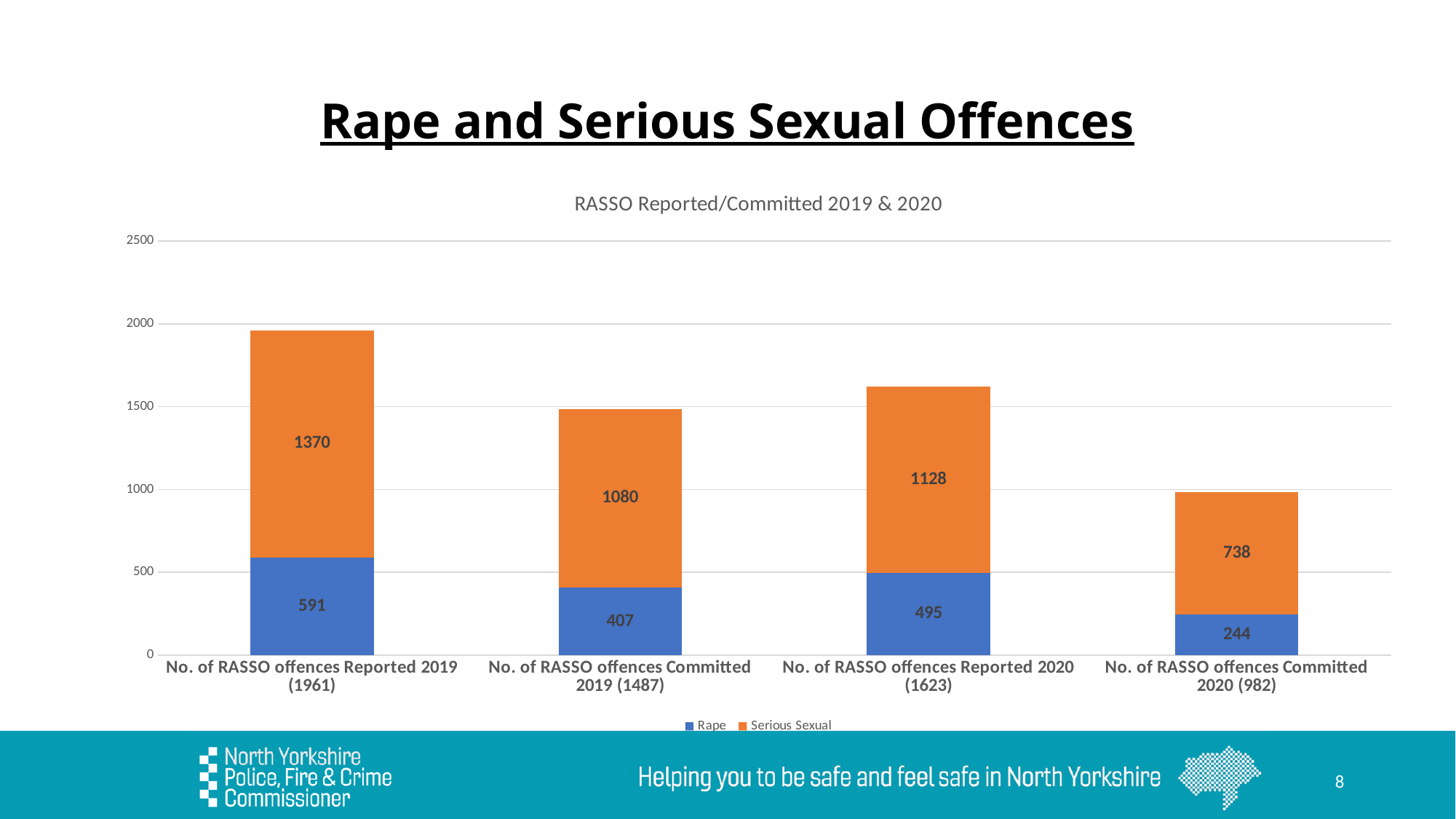
How many categories are shown on the x axis? 4 How many series does the legend list? 2 What is the Serious Sexual value for No. of RASSO offences Committed 2020? 738 What is the total of the stacked bar for No. of RASSO offences Committed 2019? 1487 What is the Serious Sexual value for No. of RASSO offences Reported 2020? 1128 Which category has the highest Serious Sexual value? No. of RASSO offences Reported 2019 What is the Rape value for No. of RASSO offences Reported 2019? 591 What is the title of the chart? RASSO Reported/Committed 2019 & 2020 Which category has the lowest Rape value? No. of RASSO offences Committed 2020 Which is larger: the Serious Sexual value for No. of RASSO offences Committed 2019 or for No. of RASSO offences Reported 2020? No. of RASSO offences Reported 2020 What kind of chart is shown on the slide? Stacked bar chart What is the difference between the Rape values for No. of RASSO offences Reported 2019 and No. of RASSO offences Reported 2020? 96